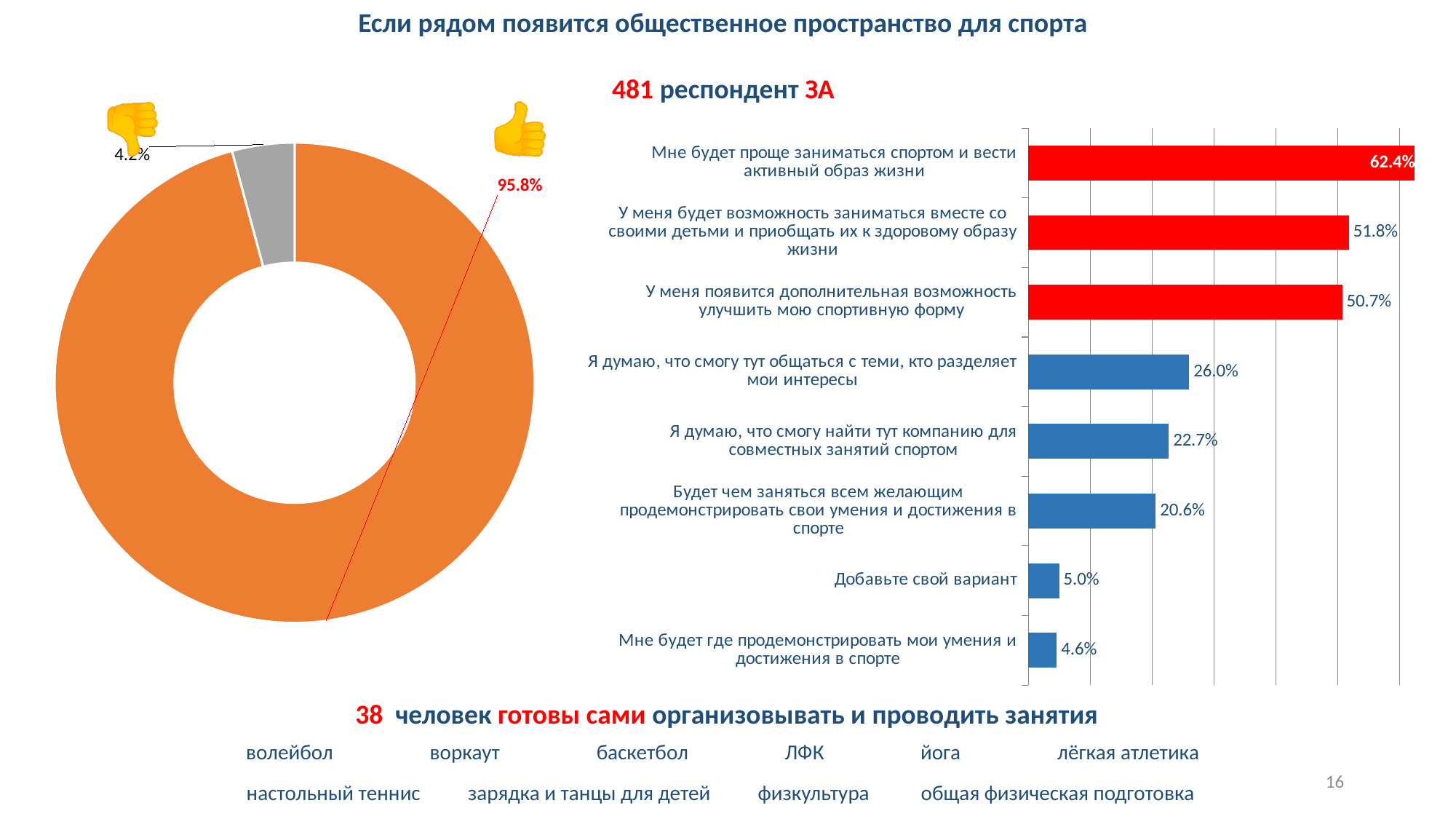
In the bar chart on the right, what is the value for "Я думаю, что смогу тут общаться с теми, кто разделяет мои интересы"? 26.0% In the donut chart on the left, what share does the orange slice represent? 95.8% In the bar chart on the right, what is the value for "Мне будет проще заниматься спортом и вести активный образ жизни"? 62.4% In the bar chart on the right, what is the value for "Добавьте свой вариант"? 5.0% In the bar chart on the right, which category has the lowest value? Мне будет где продемонстрировать мои умения и достижения в спорте In the bar chart on the right, which is larger: the value for "Я думаю, что смогу найти тут компанию для совместных занятий спортом" or for "Будет чем заняться всем желающим продемонстрировать свои умения и достижения в спорте"? Я думаю, что смогу найти тут компанию для совместных занятий спортом In the bar chart on the right, what is the difference between the values for "Мне будет проще заниматься спортом и вести активный образ жизни" and "У меня будет возможность заниматься вместе со своими детьми и приобщать их к здоровому образу жизни"? 10.6 percentage points In the bar chart on the right, which category has the highest value? Мне будет проще заниматься спортом и вести активный образ жизни In the bar chart on the right, how many bars are coloured red? 3 How many categories are shown in the bar chart on the right? 8 What kind of chart is the chart on the right of the slide? Bar chart How many slices does the donut chart on the left have? 2